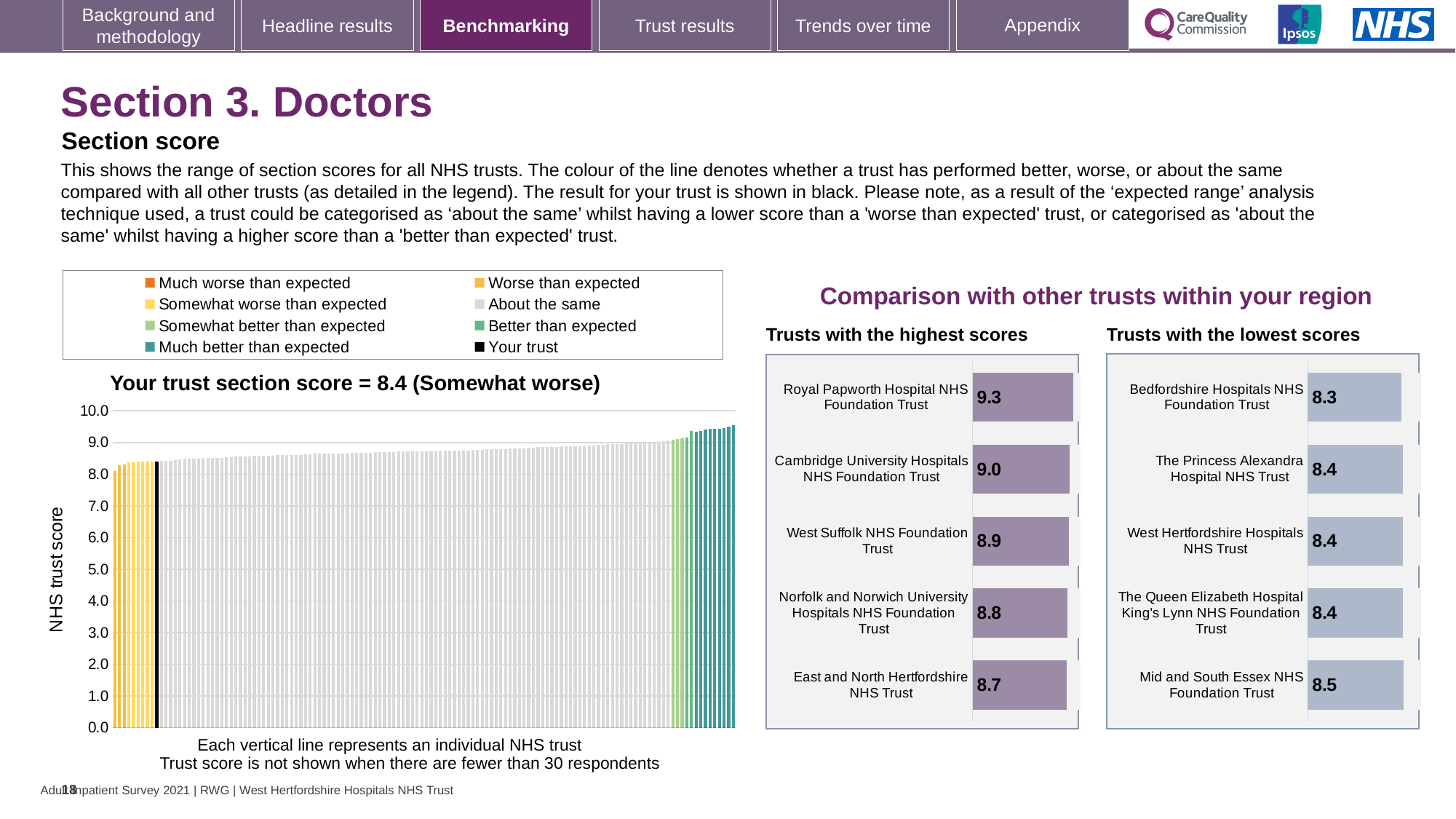
In the 'Trusts with the highest scores' chart, what is the score for Royal Papworth Hospital NHS Foundation Trust? 9.3 In the 'Trusts with the highest scores' chart, which trust has the highest score? Royal Papworth Hospital NHS Foundation Trust In the main 'Your trust section score' chart, do the bar values rise or fall from left to right along the x axis? rise How many entries does the legend above the main section score chart list? 8 In the 'Trusts with the highest scores' chart, what is the difference between the scores of Royal Papworth Hospital NHS Foundation Trust and East and North Hertfordshire NHS Trust? 0.6 In the main 'Your trust section score' chart, is the value for the black 'Your trust' bar greater or less than 9.0? less In the 'Trusts with the lowest scores' chart, which trust has the lowest score? Bedfordshire Hospitals NHS Foundation Trust In the 'Trusts with the highest scores' chart, what is the score for West Suffolk NHS Foundation Trust? 8.9 In the 'Trusts with the highest scores' chart, which has the larger score: Royal Papworth Hospital NHS Foundation Trust or Cambridge University Hospitals NHS Foundation Trust? Royal Papworth Hospital NHS Foundation Trust How many trusts are shown in the 'Trusts with the lowest scores' chart? 5 In the 'Trusts with the lowest scores' chart, what is the score for Bedfordshire Hospitals NHS Foundation Trust? 8.3 In the 'Trusts with the lowest scores' chart, what is the score for Mid and South Essex NHS Foundation Trust? 8.5